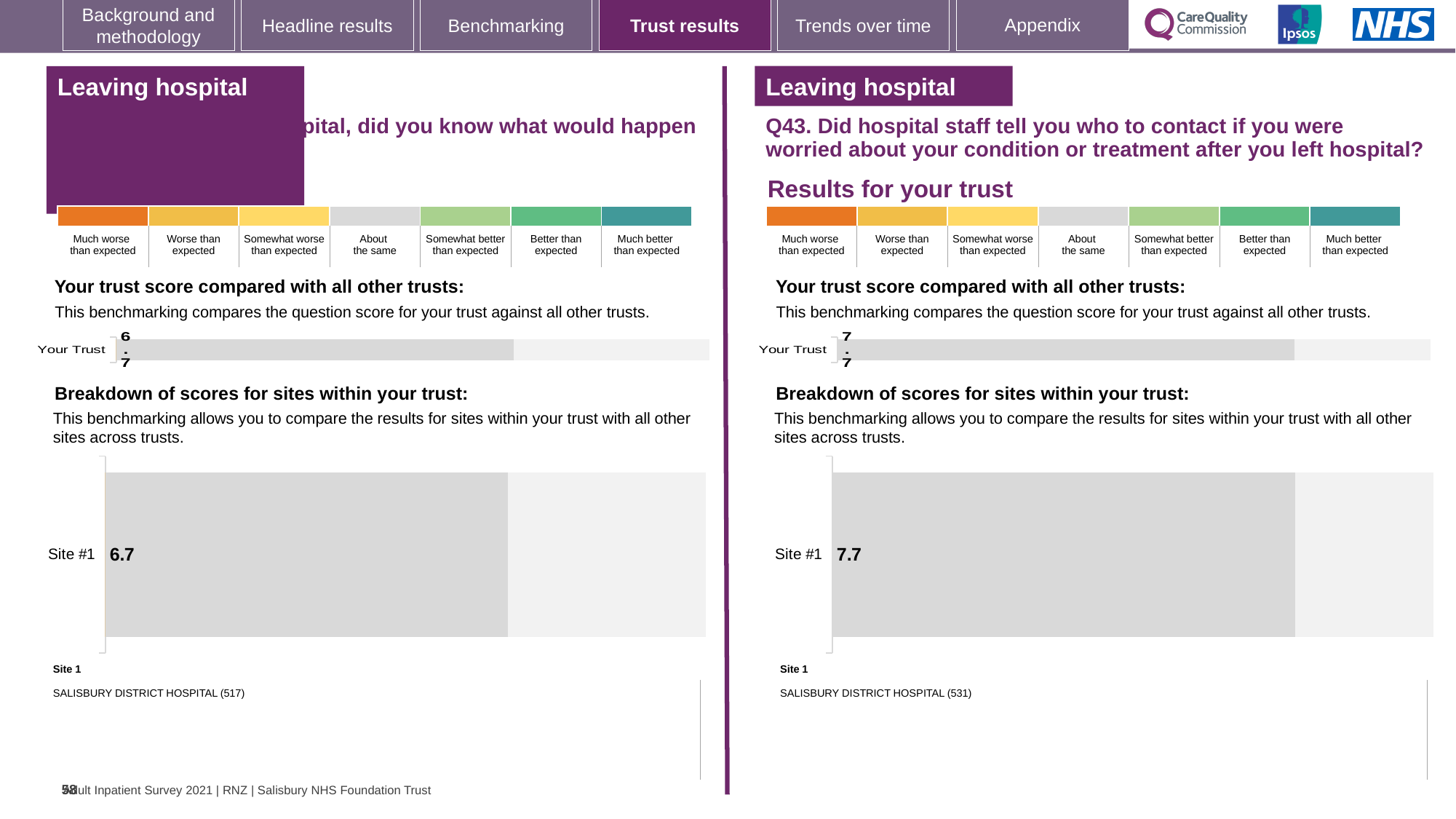
What is the difference between the Site #1 score in the right-hand (Q43) chart and the Site #1 score in the left-hand chart? 1.0 Which site is listed as Site 1 in the right-hand (Q43) site breakdown? SALISBURY DISTRICT HOSPITAL (531) On the left-hand side of the slide, what is the 'Your Trust' score shown in the trust benchmarking chart? 6.7 What type of chart is used to show the Site #1 score on the right-hand side of the slide? Bar chart Which site is listed as Site 1 in the left-hand site breakdown? SALISBURY DISTRICT HOSPITAL (517) In the right-hand (Q43) 'Breakdown of scores for sites within your trust' chart, what is the score for Site #1? 7.7 In the left-hand 'Breakdown of scores for sites within your trust' chart, what is the score for Site #1? 6.7 How many sites are shown in the left-hand 'Breakdown of scores for sites within your trust' chart? 1 Which is larger: the 'Your Trust' score on the left-hand side of the slide or the 'Your Trust' score on the right-hand side (Q43)? Right-hand side (Q43) How many sites are shown in the right-hand (Q43) 'Breakdown of scores for sites within your trust' chart? 1 On the right-hand side of the slide (Q43), what is the 'Your Trust' score shown in the trust benchmarking chart? 7.7